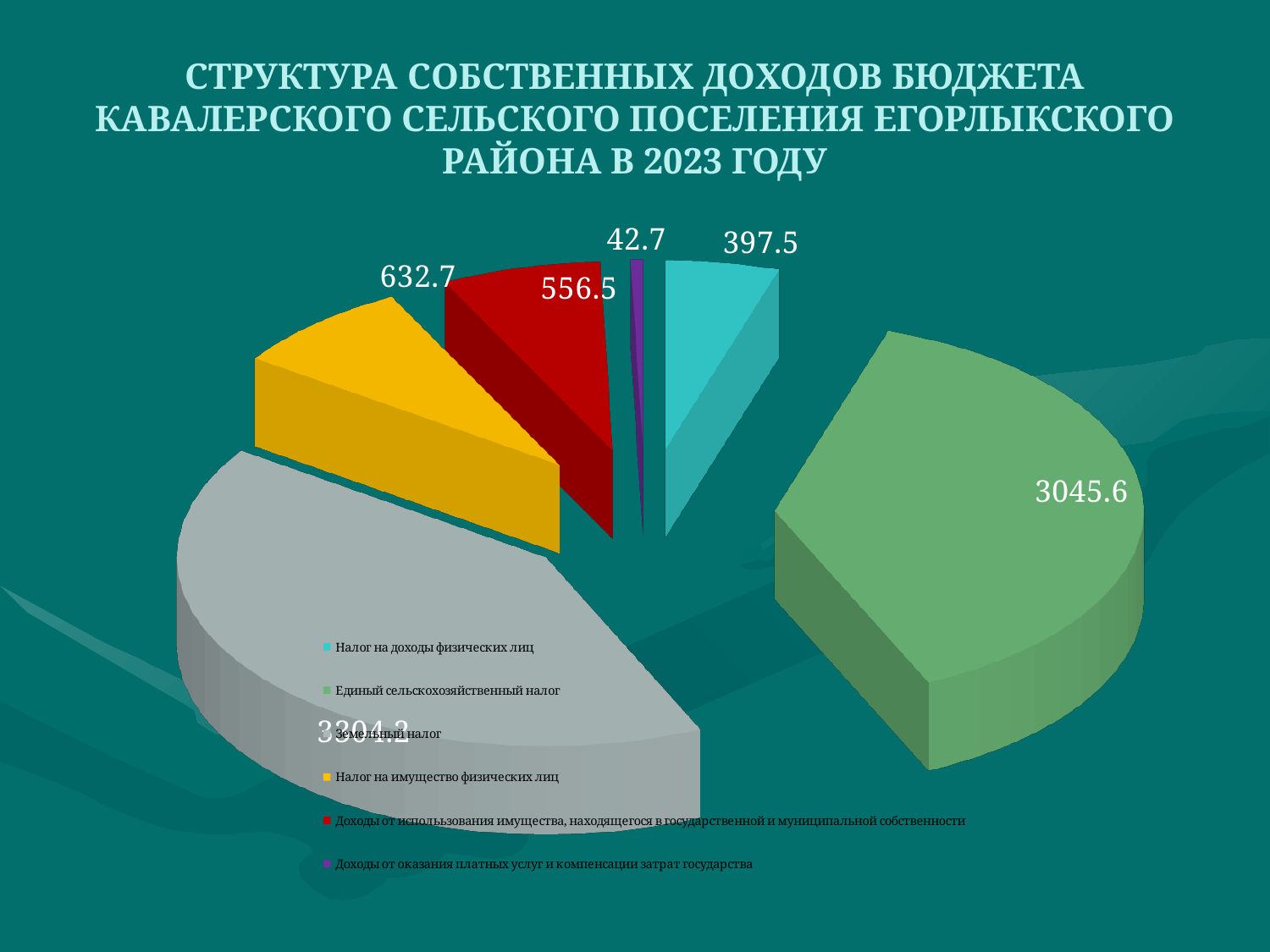
Which is larger: Налог на имущество физических лиц or Налог на доходы физических лиц? Налог на имущество физических лиц What is the value shown for Доходы от использования имущества, находящегося в государственной и муниципальной собственности? 556.5 What is the difference between the values for Единый сельскохозяйственный налог and Налог на доходы физических лиц? 2648.1 What is the value shown for Налог на доходы физических лиц? 397.5 Which category has the smallest value in the pie chart? Доходы от оказания платных услуг и компенсации затрат государства What is the value shown for Единый сельскохозяйственный налог? 3045.6 What colour represents Единый сельскохозяйственный налог in the pie chart? Green What is the difference between the values for Налог на имущество физических лиц and Доходы от использования имущества, находящегося в государственной и муниципальной собственности? 76.2 What kind of chart is shown on the slide? Pie chart What is the value shown for Налог на имущество физических лиц? 632.7 What is the value shown for Доходы от оказания платных услуг и компенсации затрат государства? 42.7 How many categories does the legend list? 6